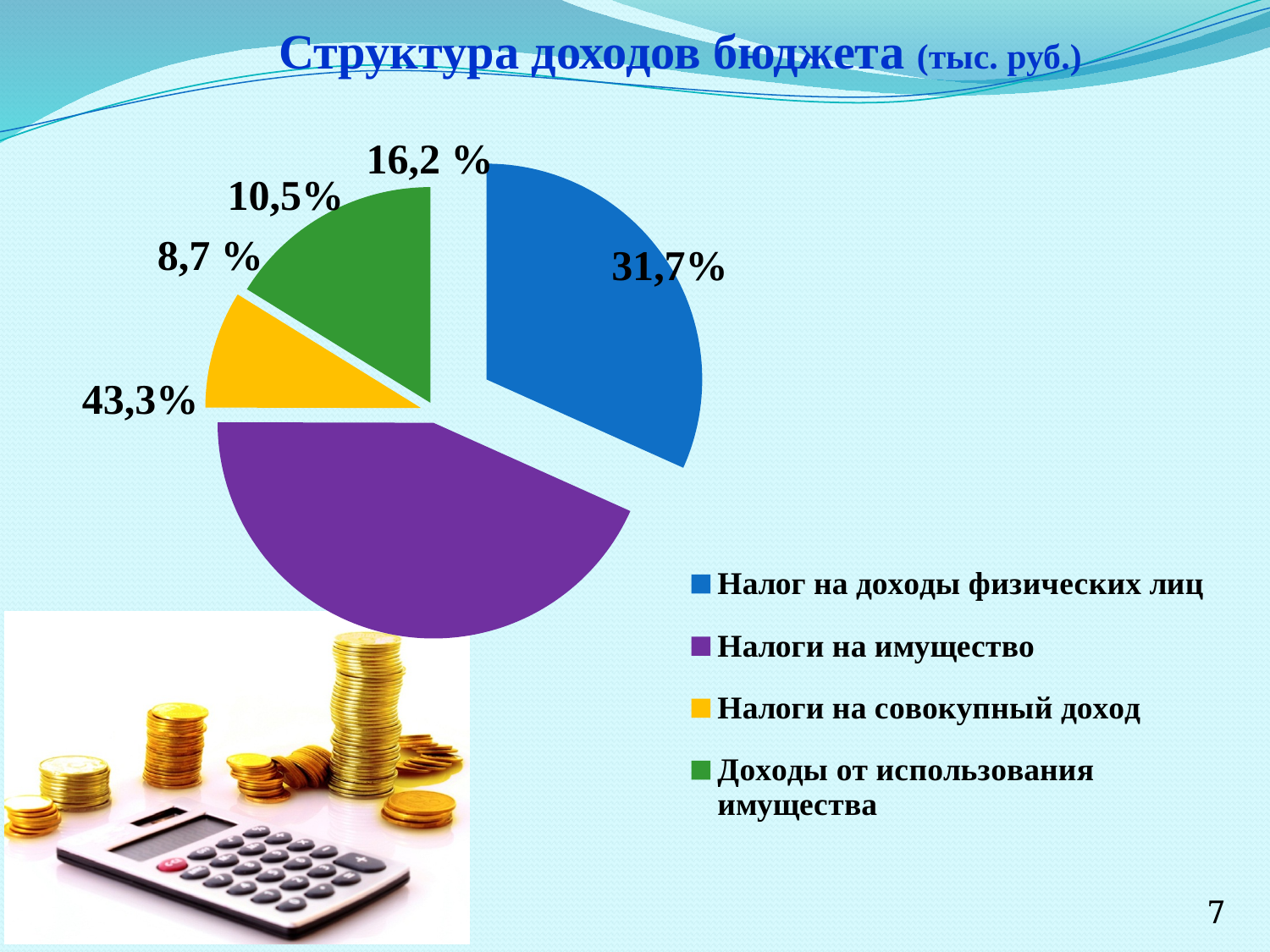
What share of the pie is labelled for Налог на доходы физических лиц? 31,7% What share of the pie is labelled for Налоги на имущество? 43,3% Which category has the smallest slice of the pie? Налоги на совокупный доход How many categories does the legend list? 4 What share of the pie is labelled for Налоги на совокупный доход? 8,7 % What kind of chart is shown on the slide? Pie chart Which is larger: the slice for Налог на доходы физических лиц or the slice for Налоги на имущество? Налоги на имущество Which is larger: the slice for Налоги на совокупный доход or the slice for Доходы от использования имущества? Доходы от использования имущества Which category has the largest slice of the pie? Налоги на имущество What colour is the slice for Налоги на имущество? Purple By how many percentage points does the Налоги на имущество slice exceed the Налог на доходы физических лиц slice? 11,6 What is the title of the chart? Структура доходов бюджета (тыс. руб.)